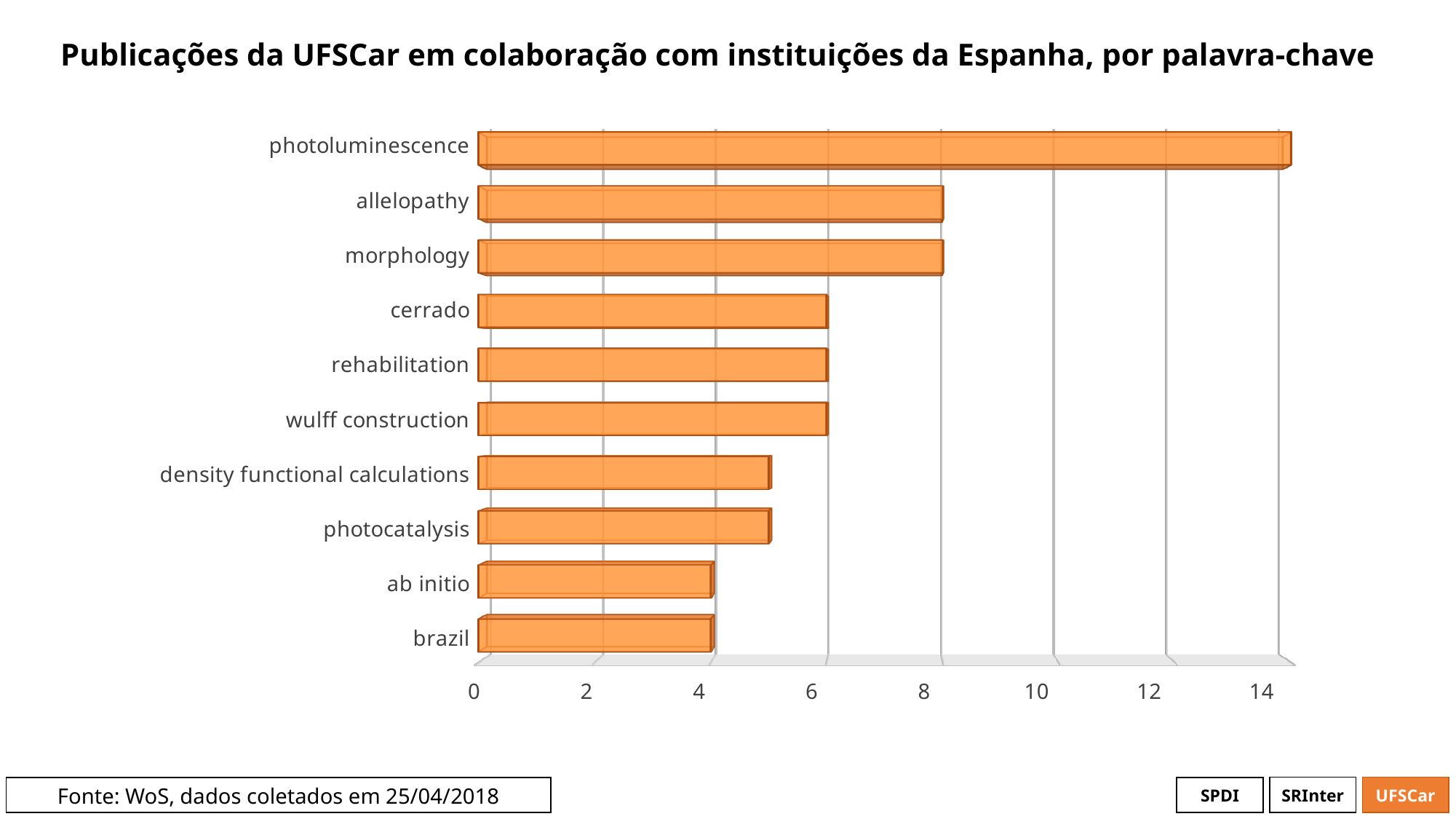
What is the title of the chart? Publicações da UFSCar em colaboração com instituições da Espanha, por palavra-chave Which keyword has the highest number of publications? photoluminescence Is the value for photocatalysis greater or less than 6? less What is the value for brazil? 4 How many keywords (categories) are plotted in the chart? 10 What kind of chart is shown on the slide? bar chart Do the bar values increase or decrease from the top of the chart to the bottom? decrease What is the value for allelopathy? 8 What is the value for photoluminescence? 14 Which has a larger value, morphology or rehabilitation? morphology Is the value for density functional calculations greater or less than 4? greater What is the value for cerrado? 6